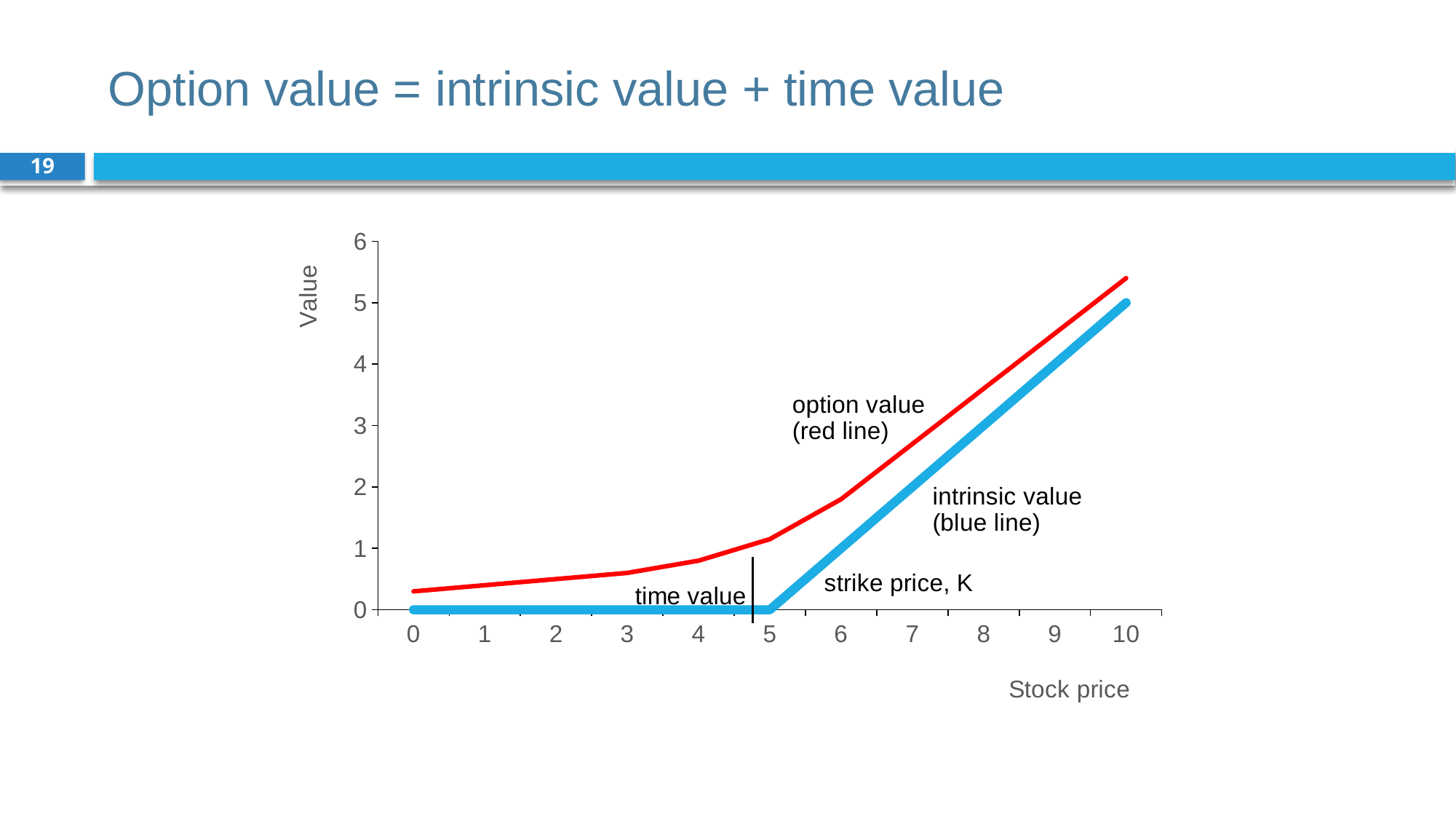
What is the title of the x axis? Stock price At what stock price does the intrinsic value (blue line) begin to rise above 0? 5 Is the option value (red line) at a stock price of 2 greater or less than 1? less What colour is the line representing the option value? red How many data series (lines) are plotted on the chart? 2 Does the intrinsic value (blue line) rise or fall as the stock price increases from 5 to 10? rise At a stock price of 7, which line is higher: the option value or the intrinsic value? option value (red line) Is the option value (red line) at a stock price of 10 greater or less than 5? greater What is the intrinsic value (blue line) at a stock price of 3? 0 What is the intrinsic value (blue line) at a stock price of 10? 5 What kind of chart is shown on the slide? line chart Is the option value (red line) at a stock price of 8 greater or less than 3? greater